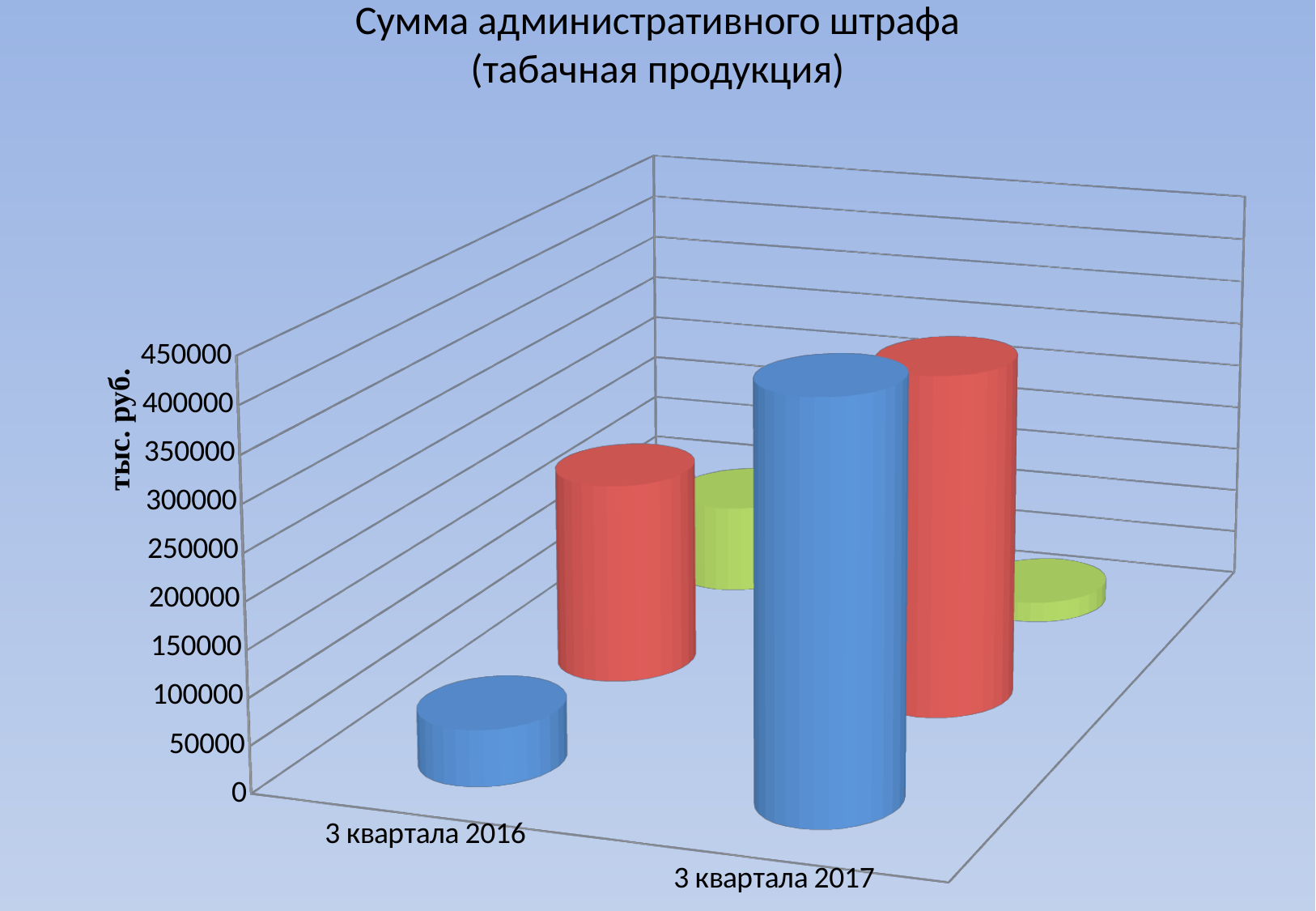
Does the blue series rise or fall from 3 квартала 2016 to 3 квартала 2017? rise Which is larger for the blue series: the value for 3 квартала 2016 or 3 квартала 2017? 3 квартала 2017 Which is larger for the red series: the value for 3 квартала 2016 or 3 квартала 2017? 3 квартала 2017 Is the red value for 3 квартала 2017 greater or less than 200000? greater Is the blue value for 3 квартала 2017 greater or less than 200000? greater What is the title of the chart? Сумма административного штрафа (табачная продукция) Is the blue value for 3 квартала 2016 greater or less than 200000? less Which category has the lowest blue value? 3 квартала 2016 What is the label on the vertical axis? тыс. руб. How many categories are shown on the x axis? 2 What kind of chart is shown on the slide? bar chart